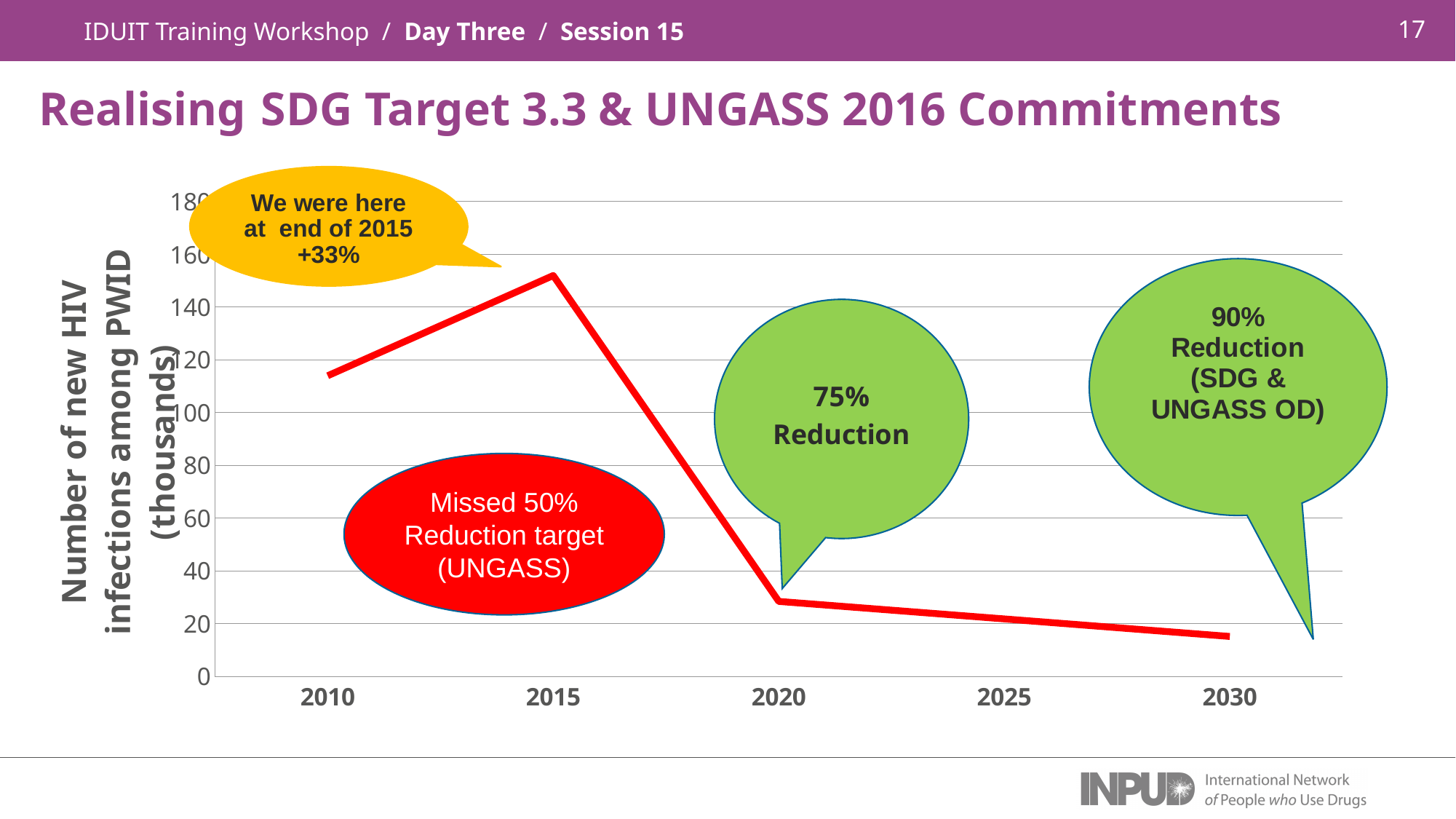
Is the value for 2020 greater or less than 40? less How many year labels are shown on the x axis? 5 Is the value for 2010 greater or less than 100? greater Which year has the larger value, 2020 or 2030? 2020 What kind of chart is shown on the slide? line chart Does the line rise or fall between 2015 and 2020? fall Is the value for 2030 greater or less than 20? less Which year has the larger value, 2010 or 2015? 2015 In which year does the line reach its lowest value? 2030 In which year does the line reach its highest value? 2015 What is the title of the y axis? Number of new HIV infections among PWID (thousands)